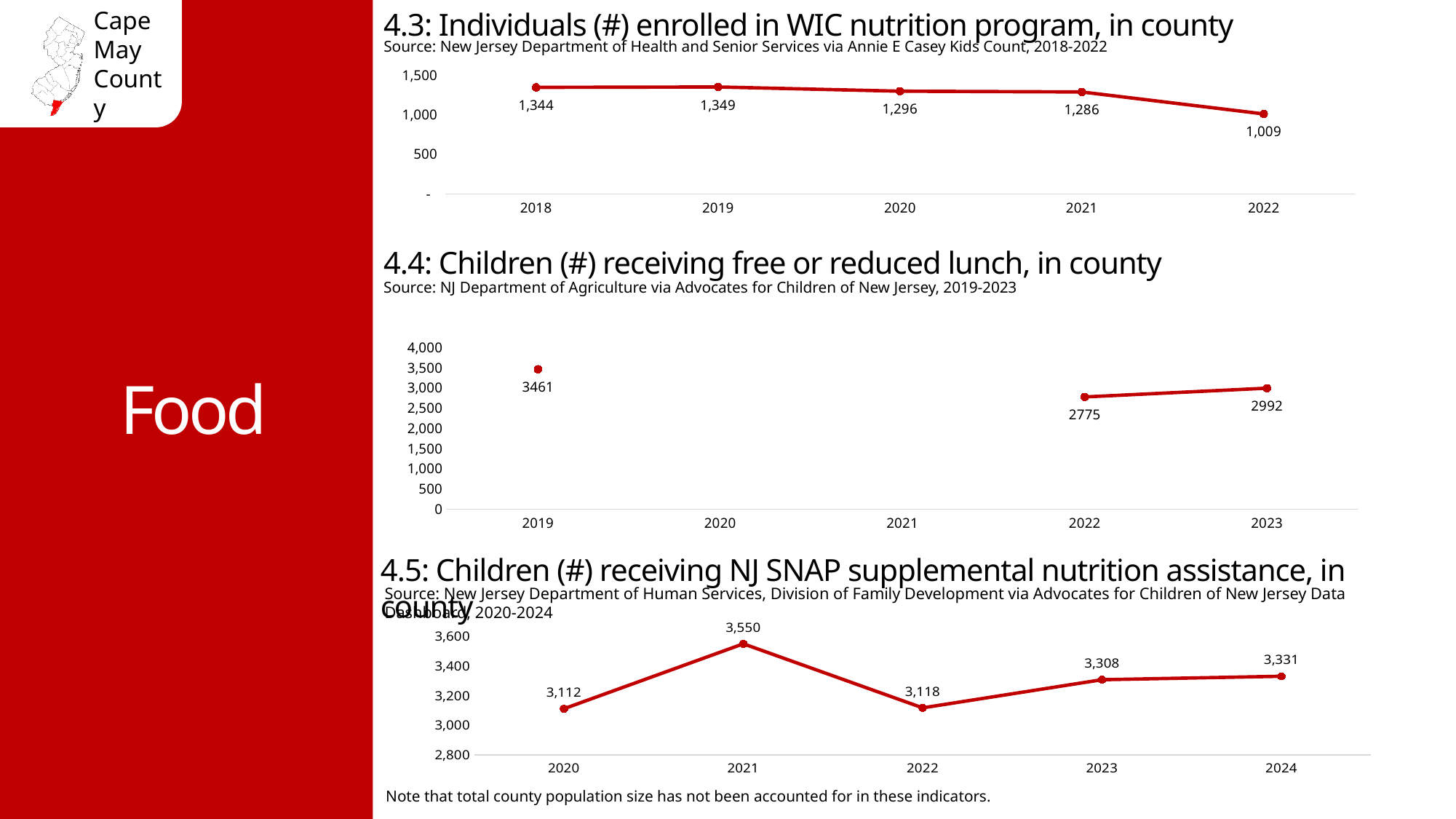
In the chart '4.3: Individuals (#) enrolled in WIC nutrition program, in county', which year has the highest value? 2019 What kind of chart is '4.5: Children (#) receiving NJ SNAP supplemental nutrition assistance, in county'? line chart In the chart '4.4: Children (#) receiving free or reduced lunch, in county', what is the value for 2019? 3461 In the chart '4.3: Individuals (#) enrolled in WIC nutrition program, in county', what is the difference between the 2018 and 2022 values? 335 In the chart '4.5: Children (#) receiving NJ SNAP supplemental nutrition assistance, in county', which year has the lowest value? 2020 In the chart '4.3: Individuals (#) enrolled in WIC nutrition program, in county', what is the value for 2022? 1,009 In the chart '4.3: Individuals (#) enrolled in WIC nutrition program, in county', do the values generally rise or fall from 2018 to 2022? fall In the chart '4.5: Children (#) receiving NJ SNAP supplemental nutrition assistance, in county', which is larger, the value for 2020 or the value for 2023? 2023 In the chart '4.4: Children (#) receiving free or reduced lunch, in county', which year has the lowest plotted value? 2022 In the chart '4.4: Children (#) receiving free or reduced lunch, in county', how many years have a plotted data point? 3 In the chart '4.5: Children (#) receiving NJ SNAP supplemental nutrition assistance, in county', what is the value for 2021? 3,550 In the chart '4.4: Children (#) receiving free or reduced lunch, in county', what is the difference between the 2023 and 2022 values? 217